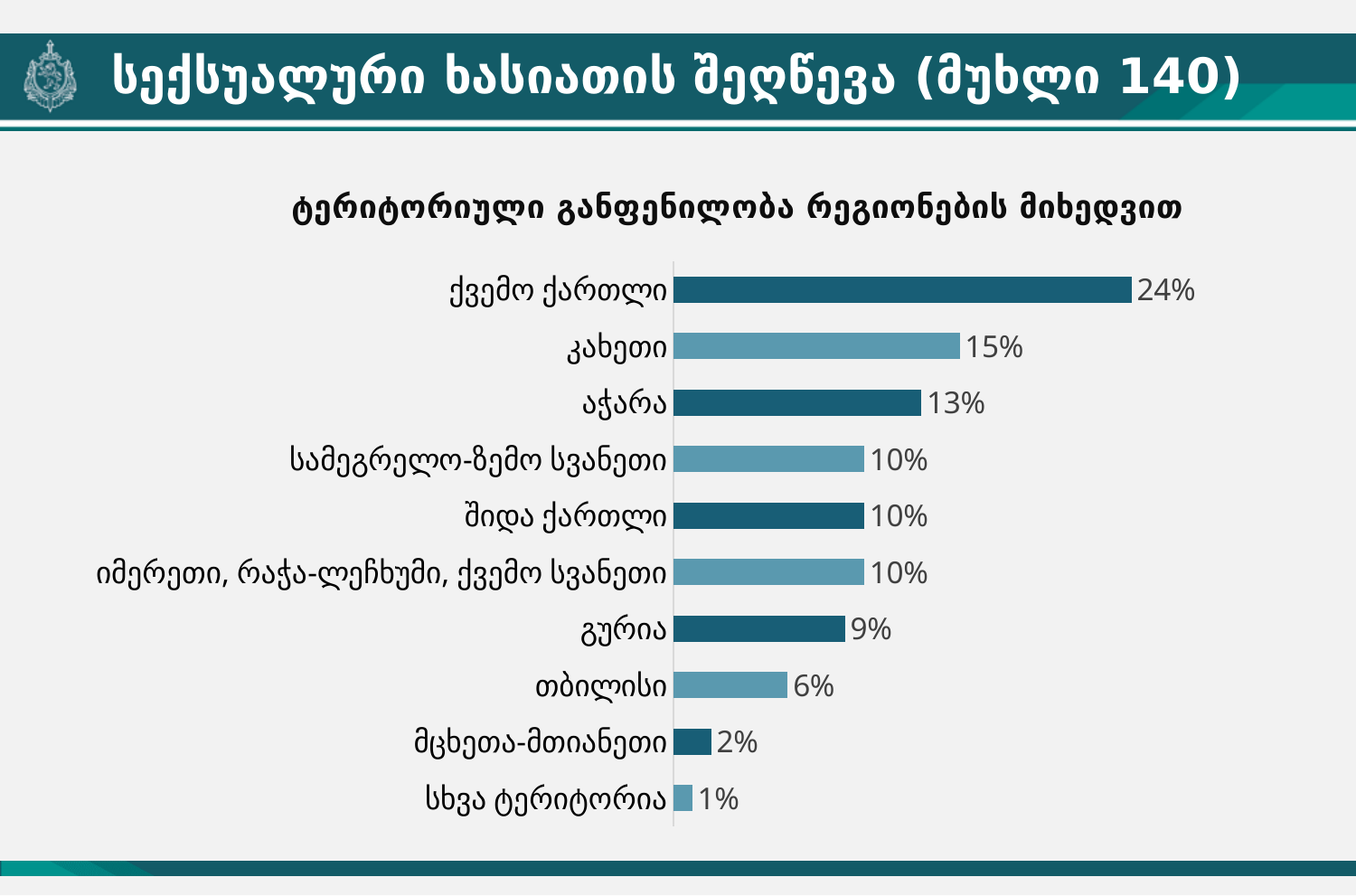
What is the value for ქვემო ქართლი? 24% Which category has the highest value? ქვემო ქართლი What kind of chart is shown on the slide? bar chart How many categories are shown in the chart? 10 What is the value for თბილისი? 6% Which category has the lowest value? სხვა ტერიტორია What is the difference between the values for ქვემო ქართლი and კახეთი? 9% What is the value for მცხეთა-მთიანეთი? 2% Which is larger, the value for აჭარა or the value for თბილისი? აჭარა What is the value for კახეთი? 15% What is the title of the chart? ტერიტორიული განფენილობა რეგიონების მიხედვით What is the difference between the values for აჭარა and გურია? 4%